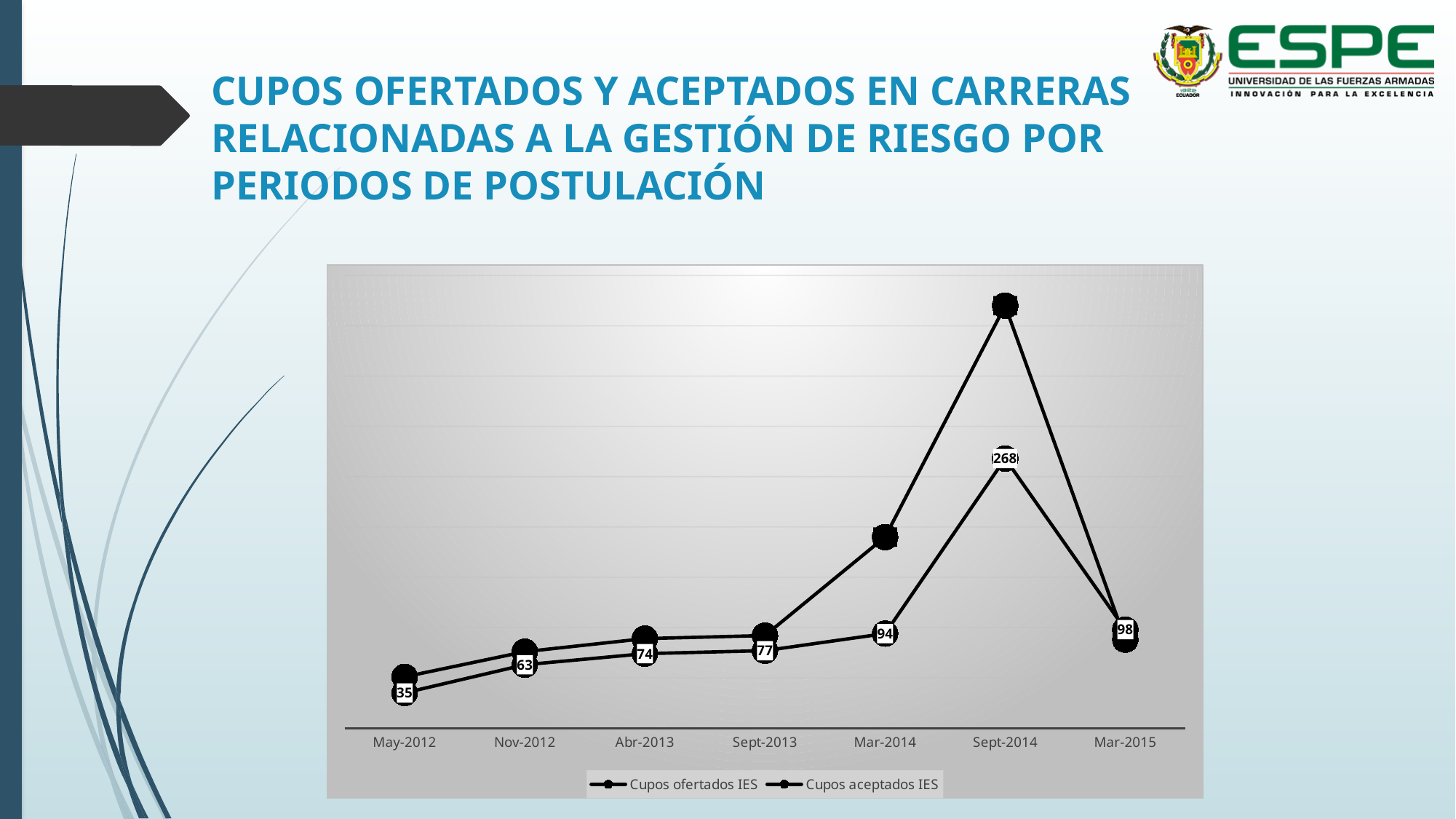
On the lower line with data labels, which period has the lowest value? May-2012 On the lower line with data labels, what is the value for May-2012? 35 How many periods are shown on the x axis of the chart? 7 What are the two series named in the chart's legend? Cupos ofertados IES and Cupos aceptados IES On the lower line with data labels, what is the difference between the values for Sept-2014 and Mar-2015? 170 On the lower line with data labels, which period has the highest value? Sept-2014 How many series does the chart's legend list? 2 What kind of chart is shown on the slide? line chart On the lower line with data labels, what is the value for Sept-2014? 268 On the lower line with data labels, do the values rise or fall from May-2012 to Sept-2013? rise On the lower line with data labels, what is the value for Mar-2015? 98 On the lower line with data labels, what is the value for Abr-2013? 74